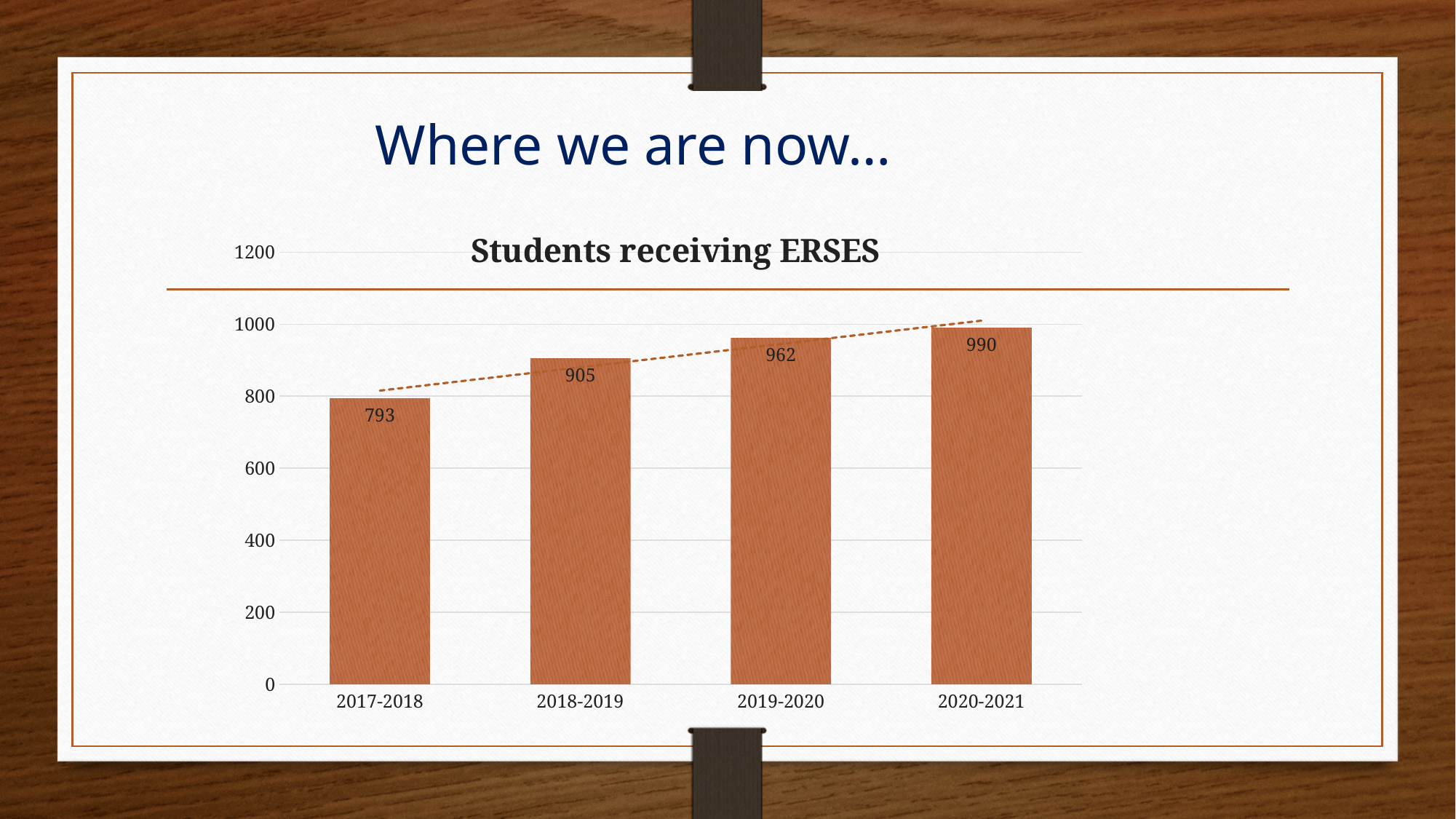
Which year has the highest number of students receiving ERSES? 2020-2021 What is the value for 2017-2018? 793 What is the value for 2020-2021? 990 What is the value for 2018-2019? 905 What kind of chart is shown on the slide? bar chart How many categories are shown on the x axis? 4 Do the values rise or fall from 2017-2018 to 2020-2021? rise What is the difference between the values for 2020-2021 and 2017-2018? 197 Which year has the lowest number of students receiving ERSES? 2017-2018 What is the value for 2019-2020? 962 Which is larger, the value for 2018-2019 or the value for 2019-2020? 2019-2020 Is the value for 2020-2021 greater or less than 1000? less